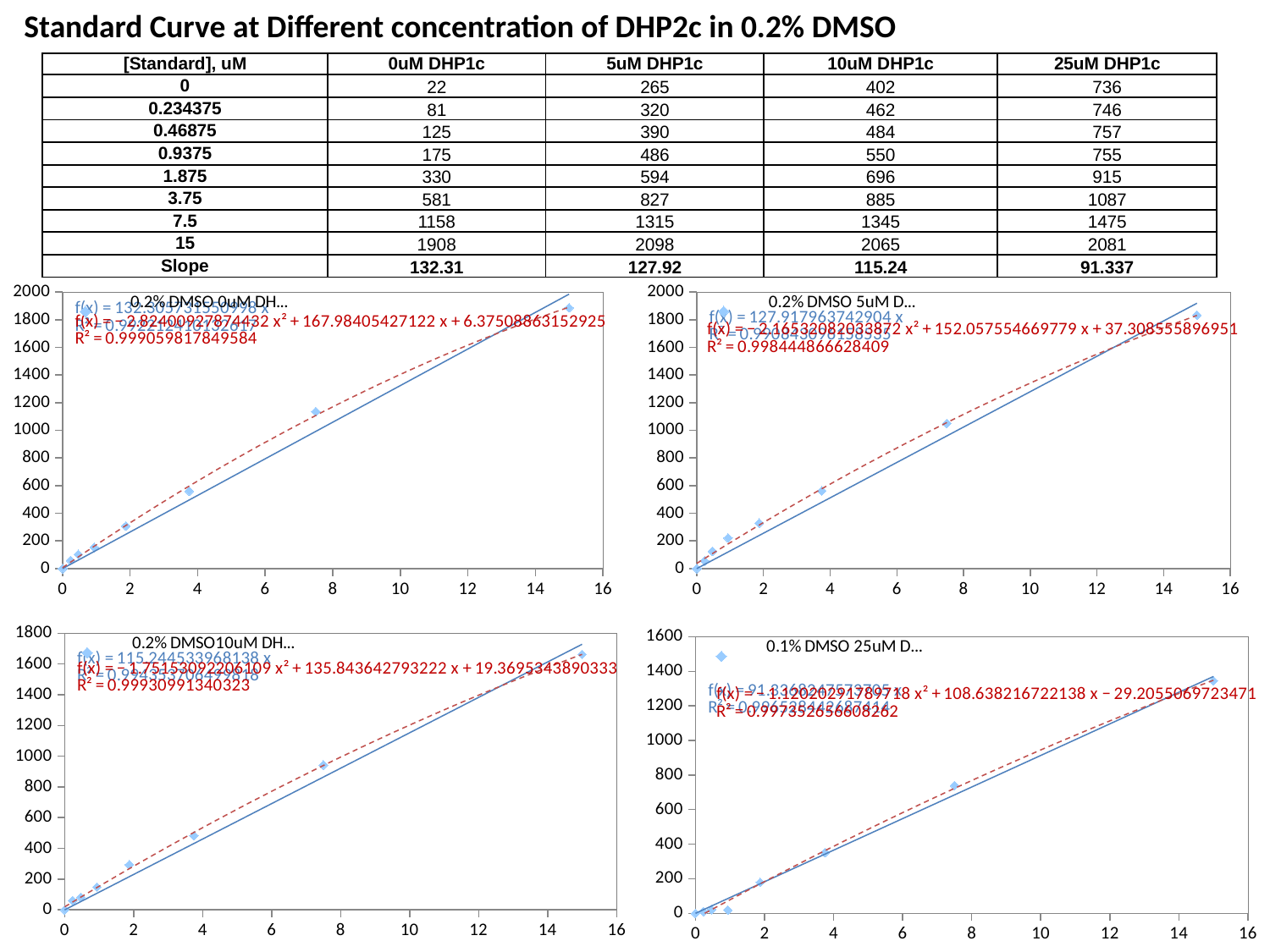
What is the maximum value shown on the y axis of the bottom-left chart (0.2% DMSO 10uM)? 1800 In the top-left chart (0.2% DMSO 0uM), is the value at x = 15 greater or less than 1800? greater How many charts are shown on the slide? 4 In the bottom-right chart (25uM), do the plotted values rise or fall as x increases? rise What kind of chart is the top-left chart (0.2% DMSO 0uM)? scatter chart In the top-left chart (0.2% DMSO 0uM), what R² value is shown in red for the polynomial fit? 0.999059817849584 In the top-right chart (0.2% DMSO 5uM), is the value at x = 7.5 greater or less than 1200? less In the bottom-left chart (0.2% DMSO 10uM), is the value at x = 3.75 greater or less than 600? less In the top-left chart (0.2% DMSO 0uM), which has the larger plotted value: x = 7.5 or x = 3.75? x = 7.5 In the top-left chart (0.2% DMSO 0uM), at which x value is the plotted y value highest? 15 In the top-left chart (0.2% DMSO 0uM), how many data points are plotted? 8